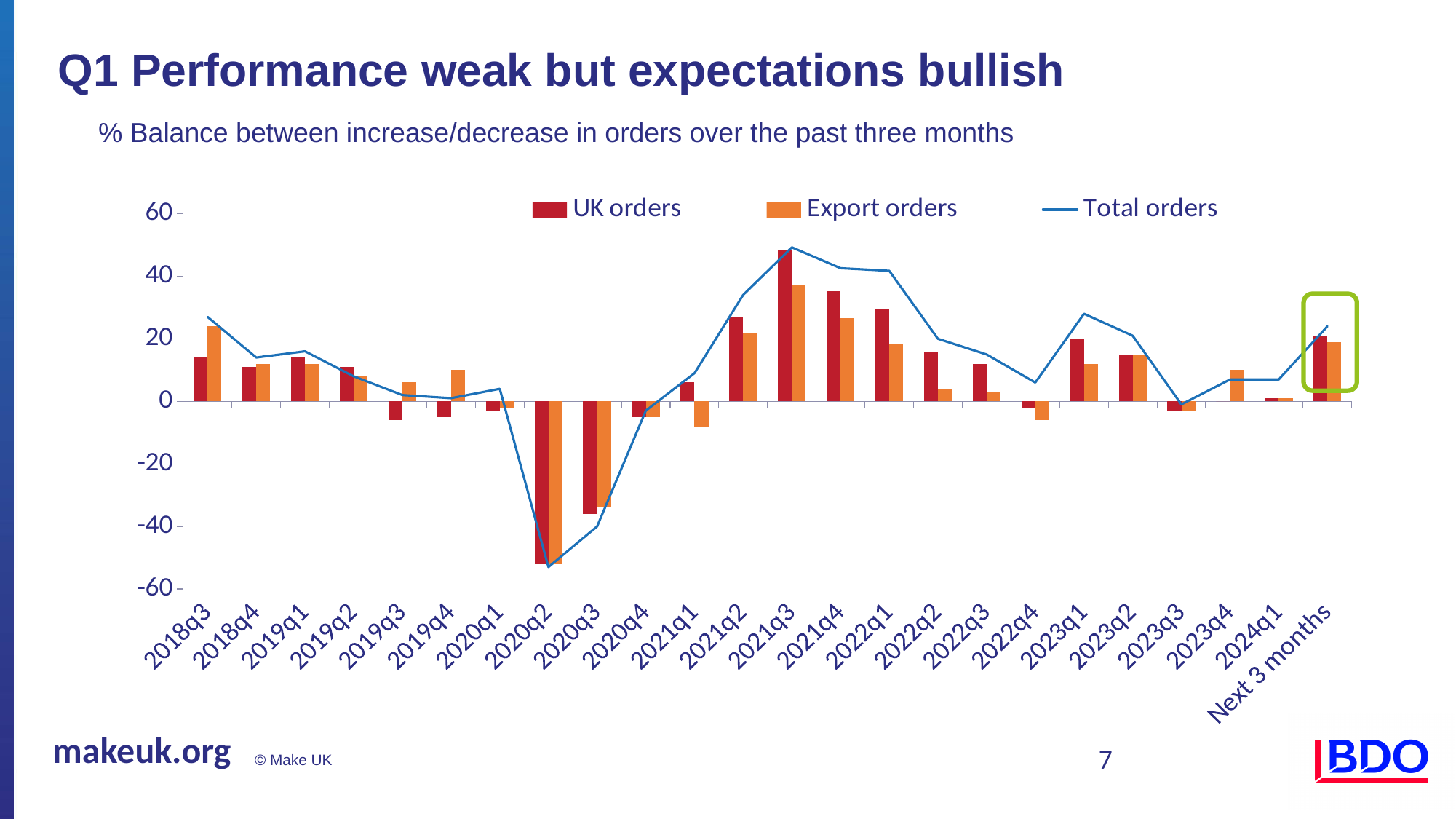
Do UK orders rise or fall from 2021q3 to 2022q4? fall Is the UK orders value for 2020q2 greater or less than -40? less Is the Export orders value for 2018q3 greater or less than 20? greater What kind of chart is used to show UK orders and Export orders? Bar chart Is the UK orders value for 2021q3 greater or less than 40? greater How many series does the legend list? 3 What are the three series named in the legend? UK orders, Export orders, Total orders In which period is the UK orders value highest? 2021q3 Which is larger in 2021q4, UK orders or Export orders? UK orders How many time periods are shown along the x axis? 24 In which period is the Export orders value lowest? 2020q2 In which period is the UK orders value lowest? 2020q2